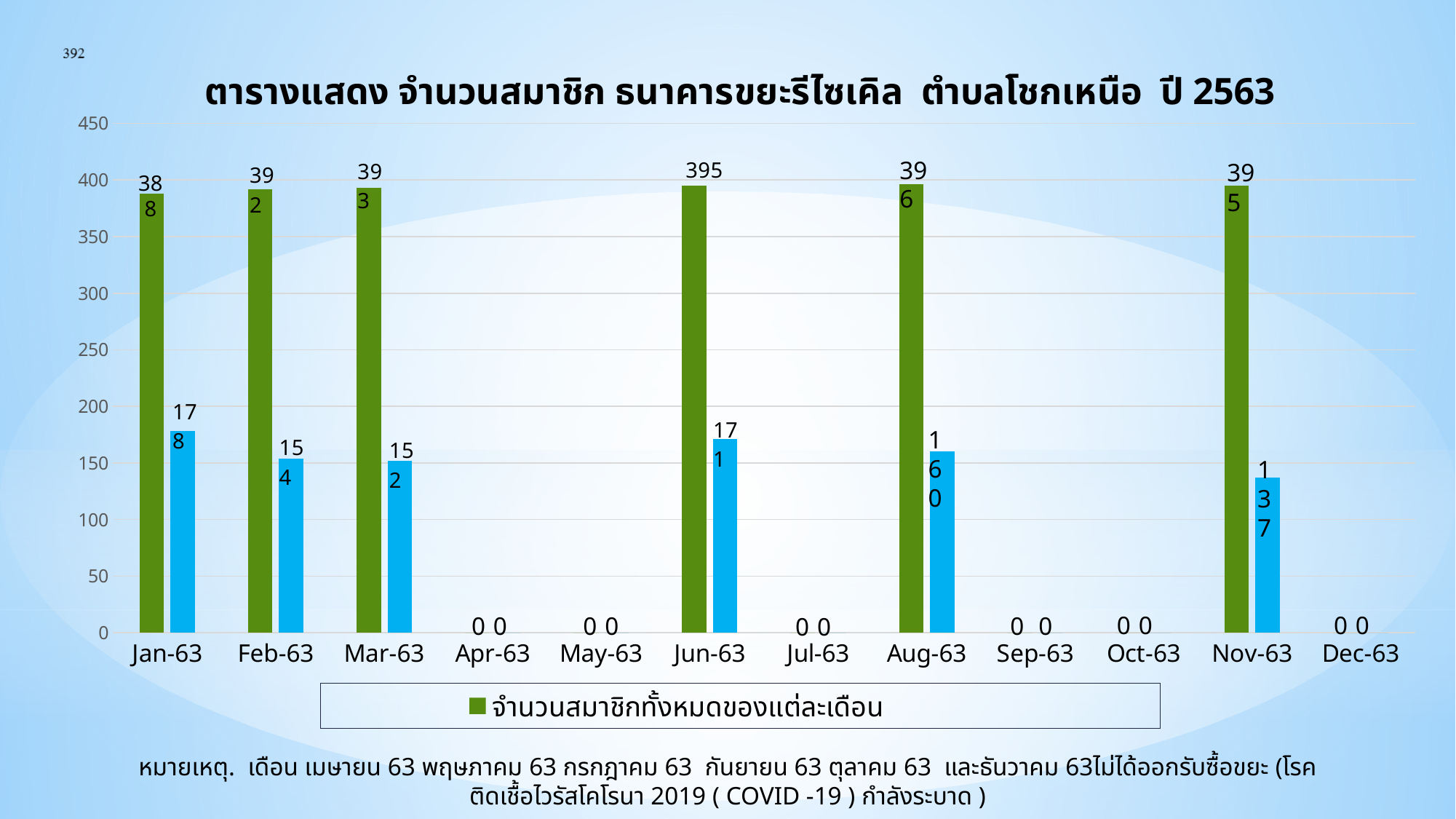
Which month has the highest value for the green series (จำนวนสมาชิกทั้งหมดของแต่ละเดือน)? Aug-63 Among the months with non-zero values, which month has the lowest blue bar? Nov-63 What kind of chart is shown on the slide? bar chart How many months show a value of 0 for both bars? 6 What is the difference between the green bar and the blue bar for Jan-63? 210 Which is larger, the blue bar for Feb-63 or the blue bar for Mar-63? Feb-63 What is the value of the blue bar for Nov-63? 137 What is the value of the blue bar for Jun-63? 171 What is the value of the green bar (จำนวนสมาชิกทั้งหมดของแต่ละเดือน) for Jan-63? 388 How many series does the legend list? 1 How many months are shown on the x axis? 12 Is the green bar for Jun-63 greater or less than 350? greater